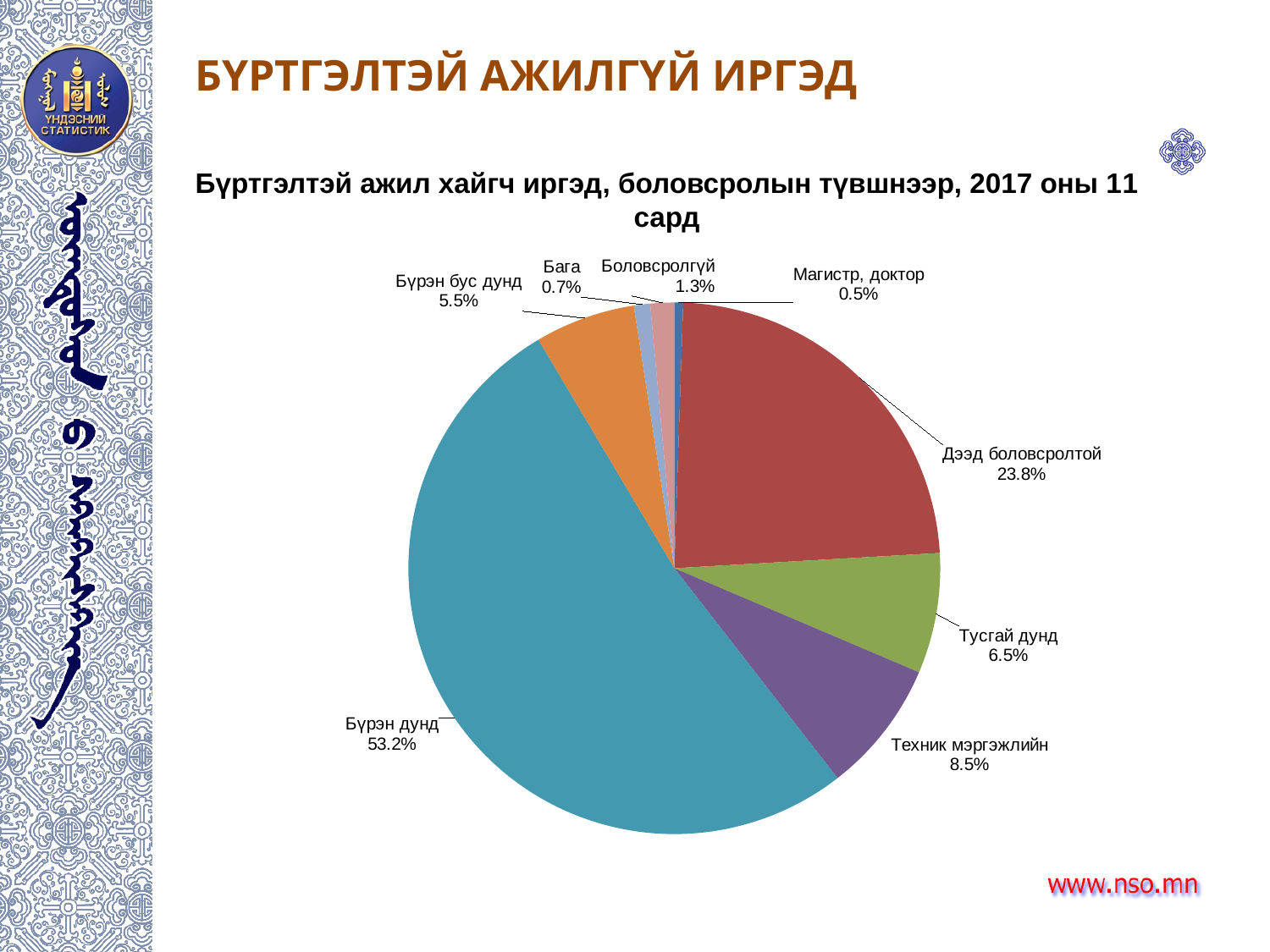
Which category has the largest slice of the pie? Бүрэн дунд What is the share for Магистр, доктор? 0.5% Which category has the smallest slice of the pie? Магистр, доктор What is the title of the chart? Бүртгэлтэй ажил хайгч иргэд, боловсролын түвшнээр, 2017 оны 11 сард How many categories are shown in the pie chart? 8 What is the share for Бүрэн дунд? 53.2% What is the difference between the shares of Бүрэн дунд and Дээд боловсролтой? 29.4% What kind of chart is shown on the slide? pie chart What is the difference between the shares of Техник мэргэжлийн and Тусгай дунд? 2.0% What is the share for Техник мэргэжлийн? 8.5% What is the share for Дээд боловсролтой? 23.8% Which is larger, the share for Тусгай дунд or the share for Бүрэн бус дунд? Тусгай дунд